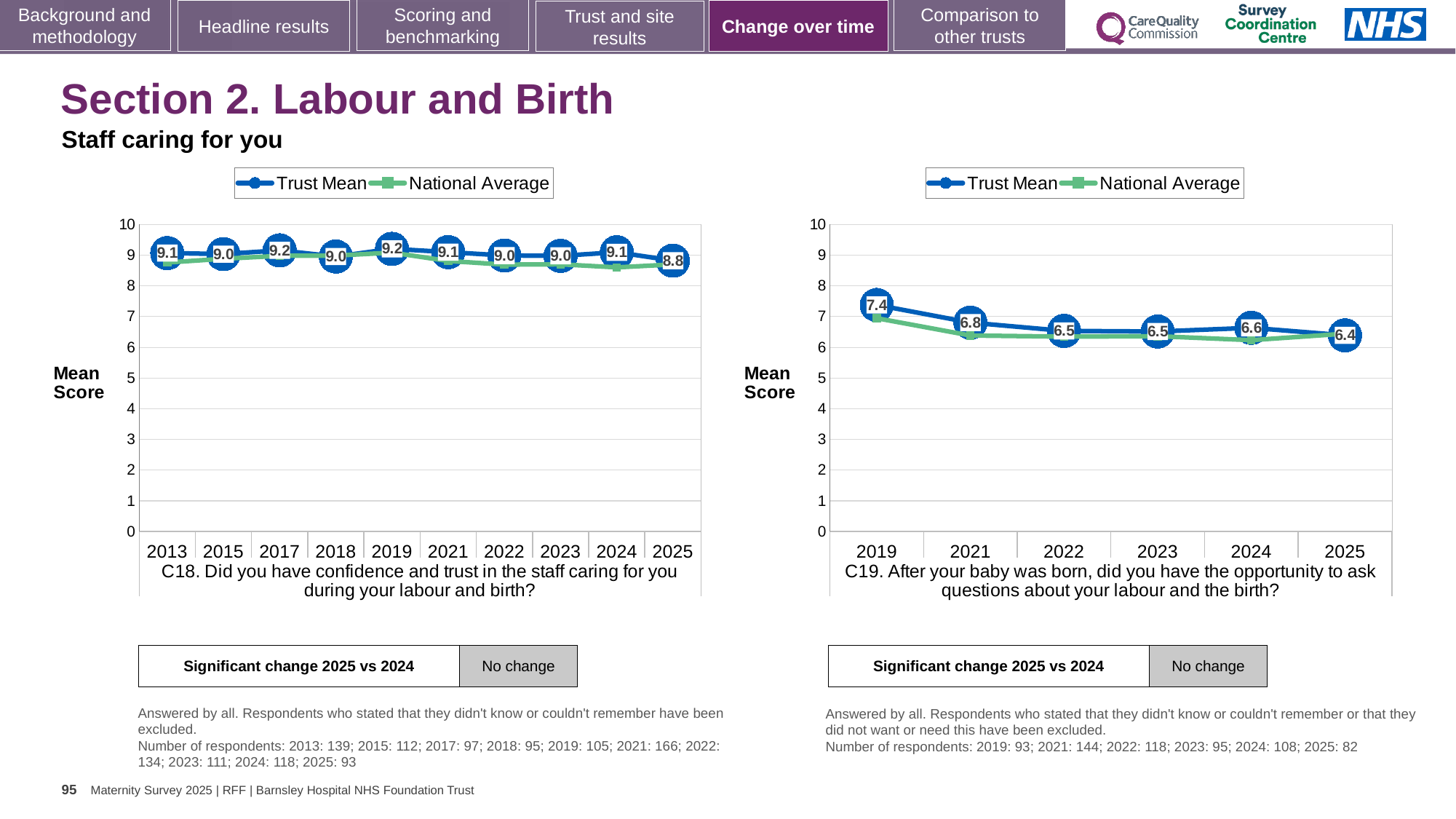
How many series does the legend of the left chart (C18) list? 2 In the left chart (C18), which year has the lowest Trust Mean? 2025 In the right chart (C19), which year has the highest Trust Mean? 2019 In the right chart (C19), what is the difference between the Trust Mean for 2019 and for 2025? 1.0 In the right chart (C19), what is the Trust Mean for 2019? 7.4 In the right chart (C19), is the National Average for 2019 greater or less than 6? greater How many years are plotted on the x axis of the right chart (C19)? 6 In the left chart (C18), is the Trust Mean for 2024 larger or smaller than for 2025? larger In the left chart (C18), what is the Trust Mean for 2019? 9.2 In the right chart (C19), what is the Trust Mean for 2025? 6.4 What type of chart is the left chart (C18)? line chart In the left chart (C18), what is the Trust Mean for 2025? 8.8